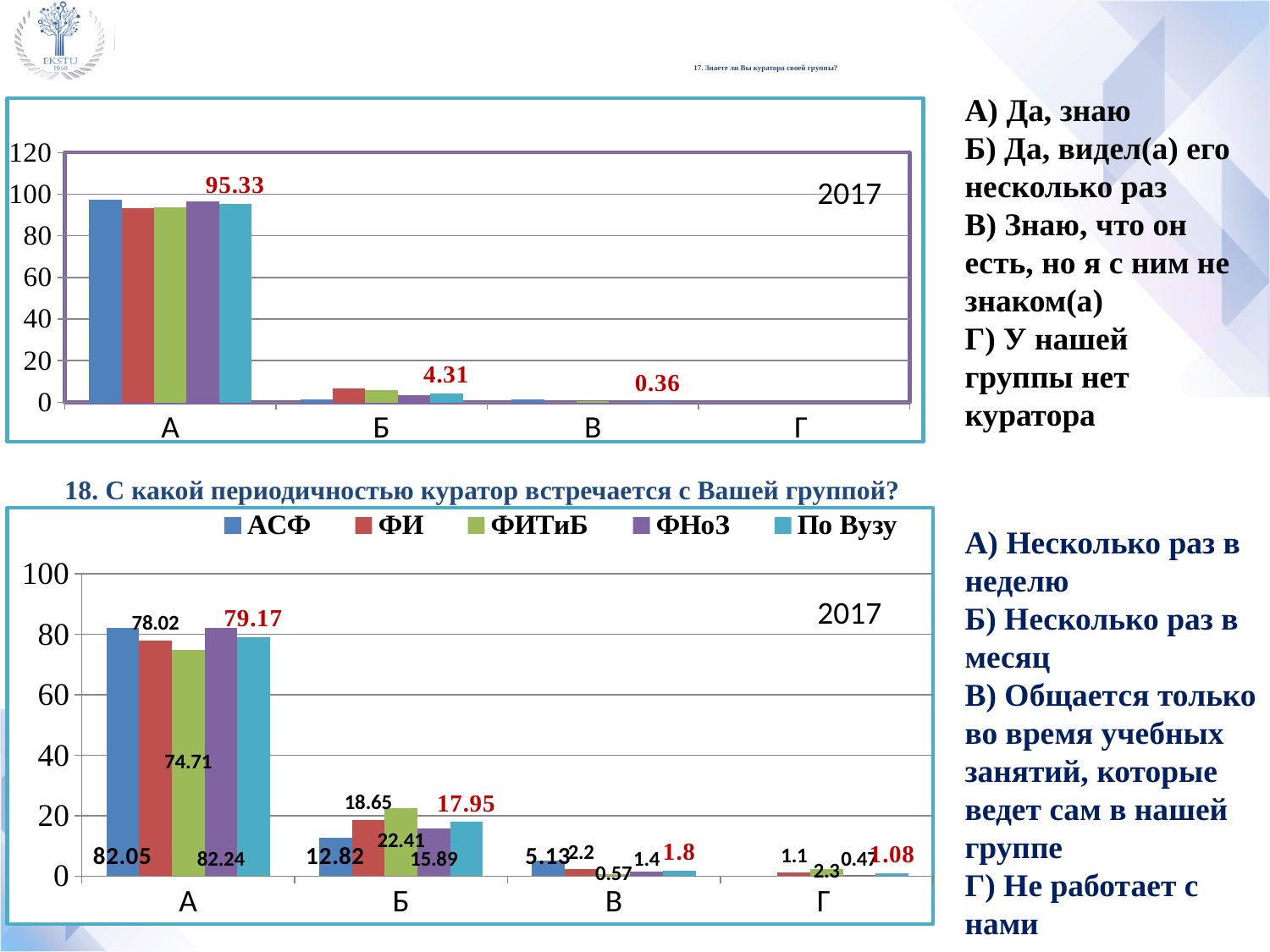
How many series does the legend of the bottom chart (question 18) list? 5 In the bottom chart (question 18), what is the value for По Вузу in category В? 1.8 In the bottom chart (question 18), which is larger in category Б: ФИ or АСФ? ФИ In the bottom chart (question 18), what is the value for ФИТиБ in category Б? 22.41 In the top chart, which category has the highest values? А In the top chart, what is the value labelled for category А? 95.33 In the bottom chart (question 18), what is the value for АСФ in category А? 82.05 What kind of chart is the bottom chart (question 18)? bar chart In the top chart, what is the value labelled for category В? 0.36 In the top chart, what is the value labelled for category Б? 4.31 In the bottom chart (question 18), is the value for ФИТиБ in category А greater or less than 80? less In the bottom chart (question 18), what is the difference between ФНоЗ and ФИ in category А? 4.22